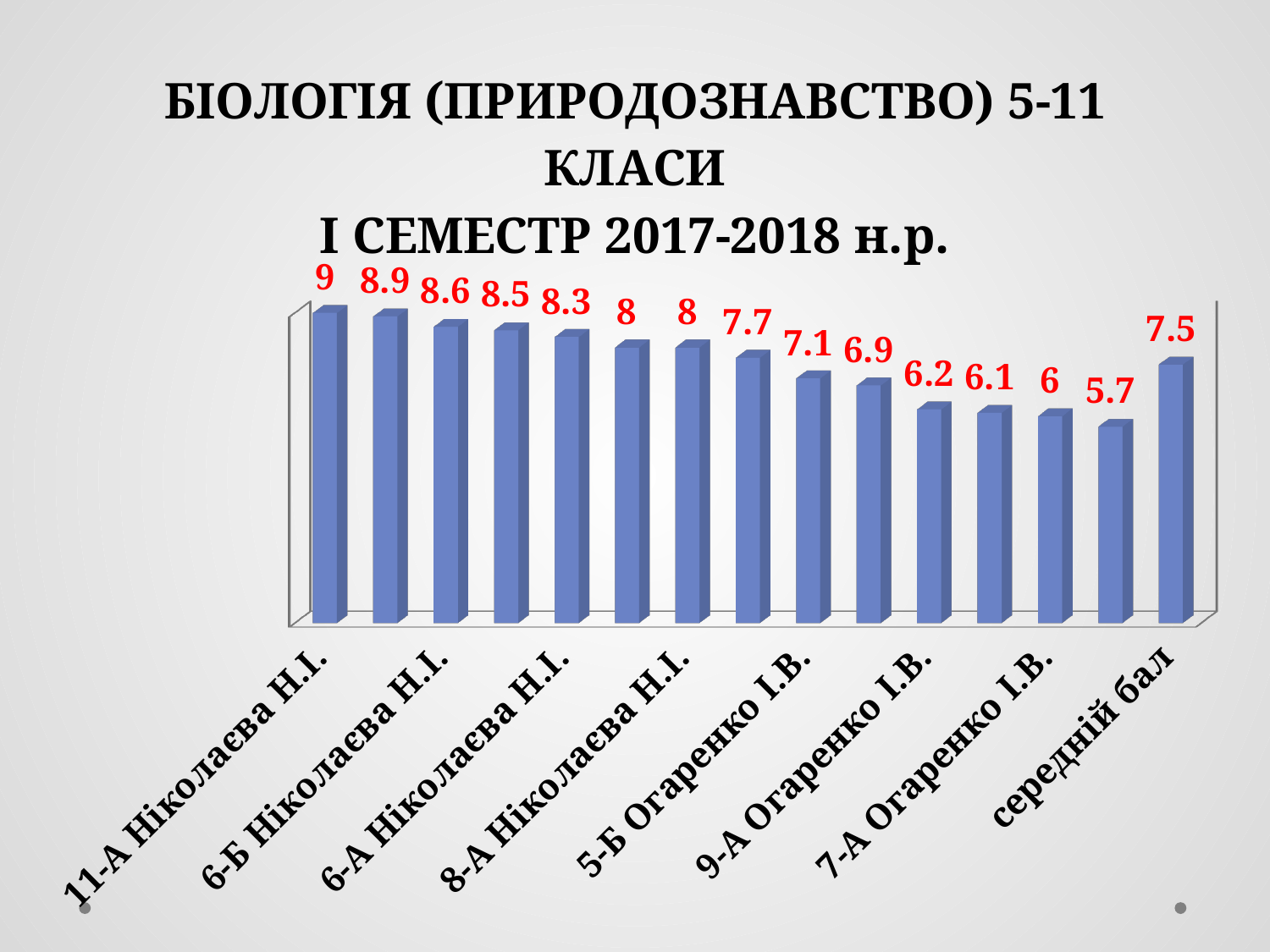
Which labelled category has the highest value? 11-А Ніколаєва Н.І. What is the lowest value shown on any bar in the chart? 5.7 What is the value for середній бал? 7.5 What kind of chart is shown on the slide? bar chart What is the value for 5-Б Огаренко І.В.? 7.1 What is the value for 11-А Ніколаєва Н.І.? 9 Which is larger, the value for 6-Б Ніколаєва Н.І. or 5-Б Огаренко І.В.? 6-Б Ніколаєва Н.І. What is the value for 6-Б Ніколаєва Н.І.? 8.6 What is the value for 7-А Огаренко І.В.? 6 What is the difference between the value for 11-А Ніколаєва Н.І. and середній бал? 1.5 Do the class values rise or fall from left to right across the chart (before the final середній бал bar)? fall How many bars are plotted in the chart? 15